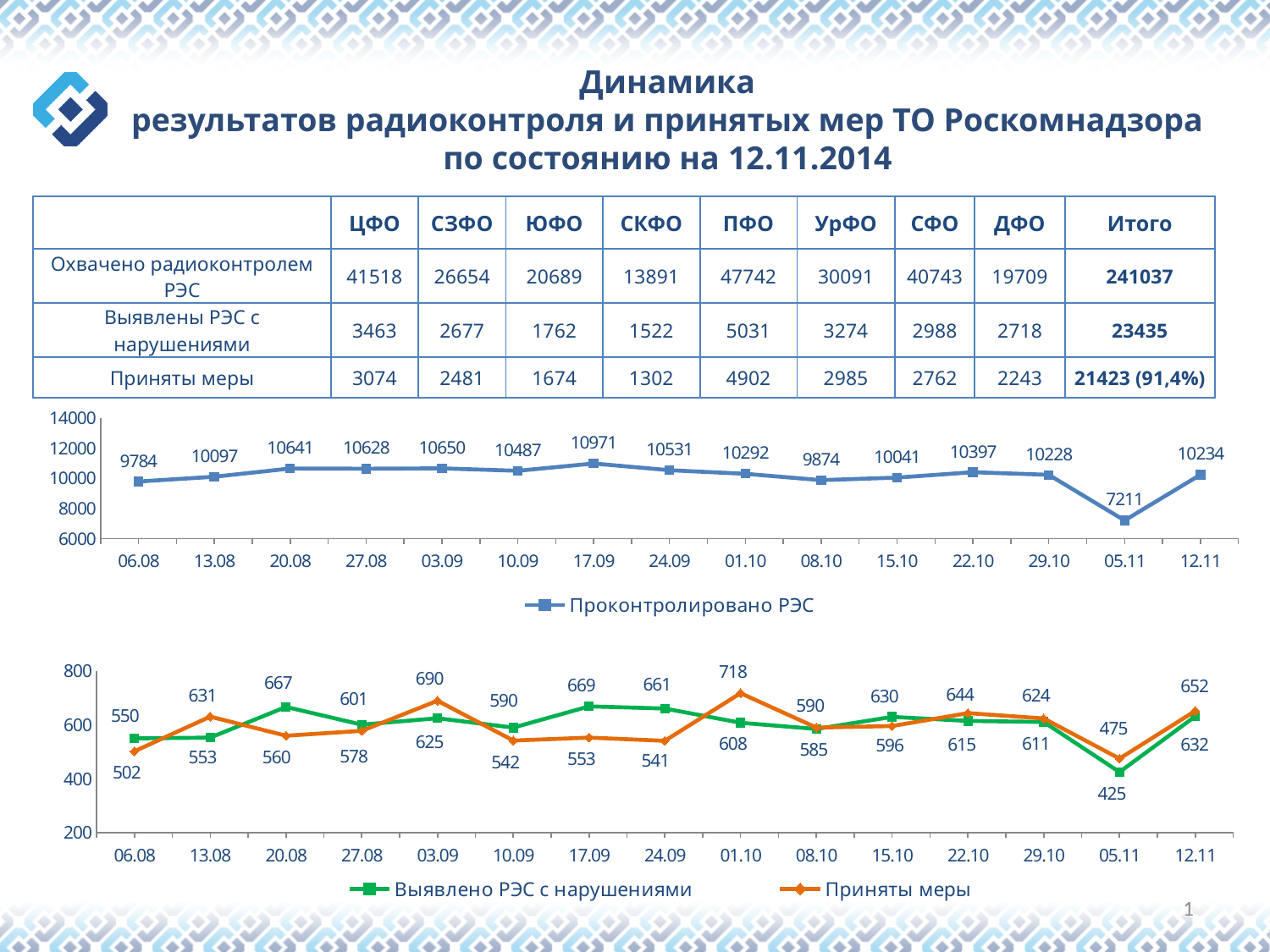
In the top chart, what is the value of Проконтролировано РЭС on 17.09? 10971 In the top chart, on which date is Проконтролировано РЭС lowest? 05.11 In the bottom chart, how many series does the legend list? 2 In the top chart, on which date is Проконтролировано РЭС highest? 17.09 In the bottom chart, what is the value of Приняты меры on 01.10? 718 In the bottom chart, what is the difference between Выявлено РЭС с нарушениями and Приняты меры on 24.09? 120 What type of chart is the top chart? Line chart In the bottom chart, what is the value of Выявлено РЭС с нарушениями on 05.11? 425 In the top chart, how many dates are plotted on the x axis? 15 In the bottom chart, is the value of Приняты меры on 05.11 greater or less than 600? less In the bottom chart, which is larger on 03.09: Выявлено РЭС с нарушениями or Приняты меры? Приняты меры In the top chart, what is the difference between the values on 29.10 and 05.11? 3017